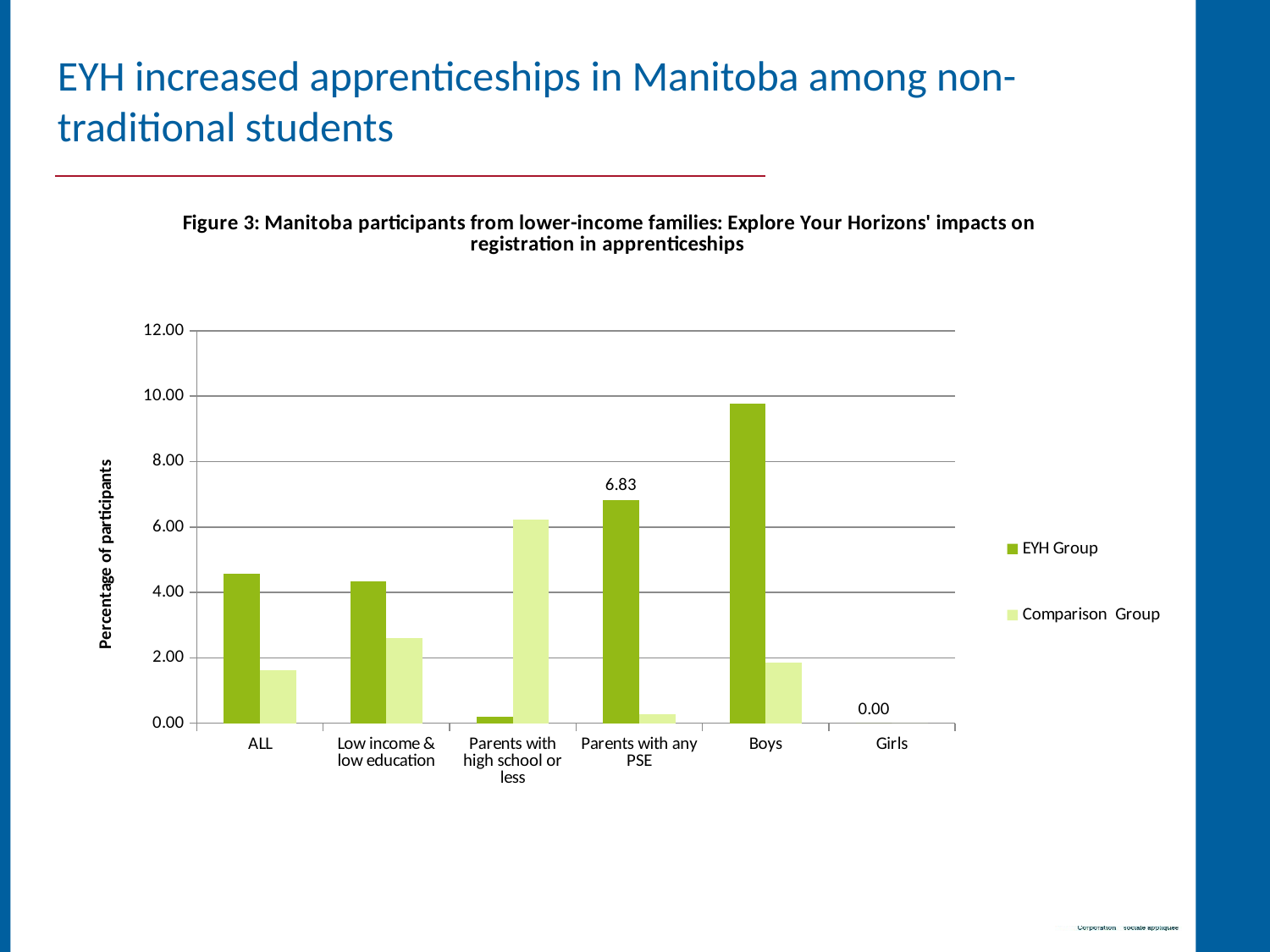
What value is labelled for the Girls category? 0.00 What is the value for the EYH Group in the 'Parents with any PSE' category? 6.83 Which category has the highest value for the EYH Group? Boys Is the value for the Comparison Group in the ALL category greater or less than 2.00? less Which category has the highest value for the Comparison Group? Parents with high school or less Is the value for the EYH Group in the Boys category greater or less than 8.00? greater In the 'Parents with high school or less' category, which series has the larger value? Comparison Group What is the title of the y axis? Percentage of participants What type of chart is shown on the slide? bar chart In the ALL category, which series has the larger value, EYH Group or Comparison Group? EYH Group How many categories are shown on the x axis? 6 How many series does the legend list? 2